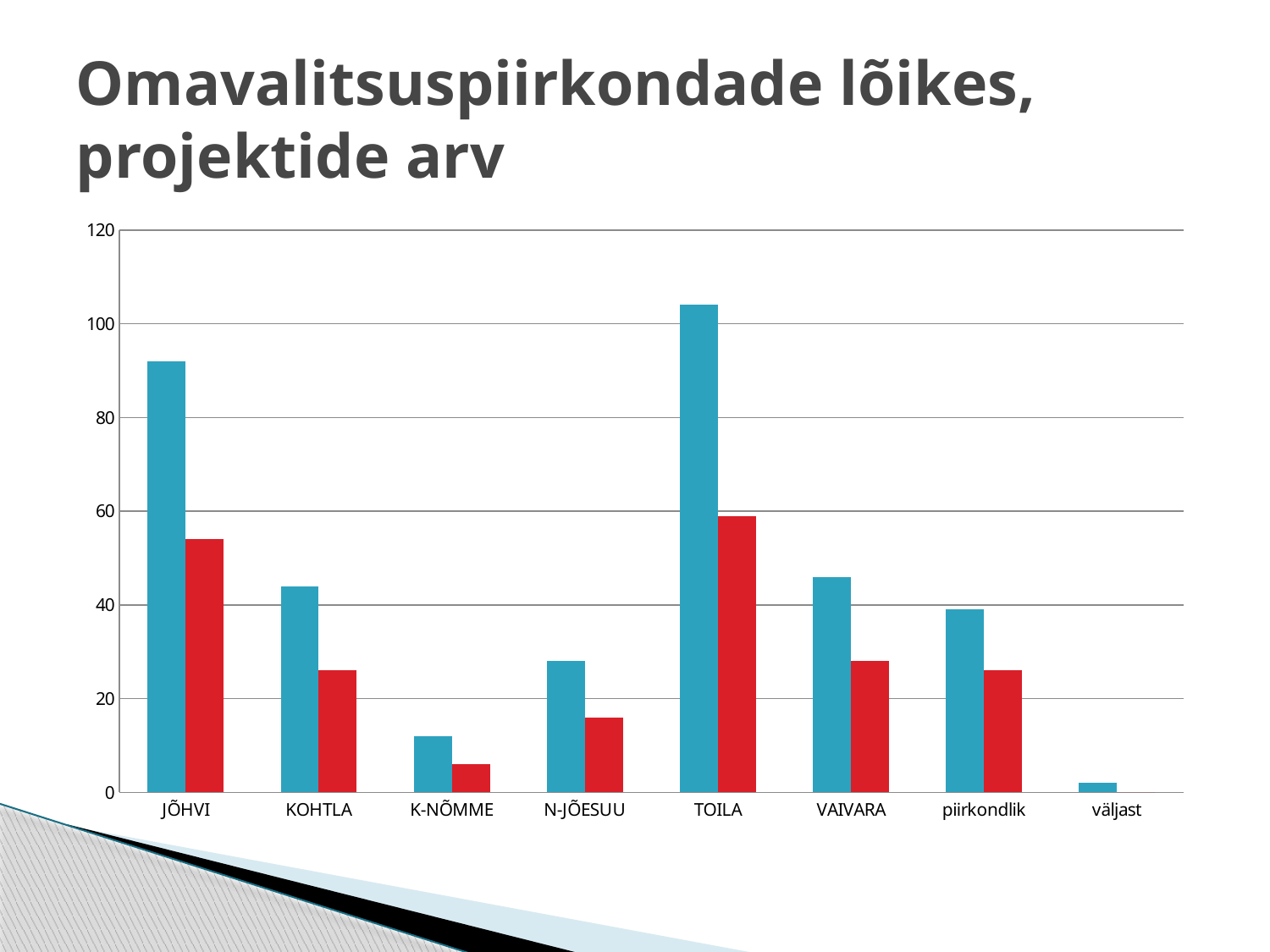
What kind of chart is shown on the slide? bar chart How many categories are shown on the x axis of the chart? 8 What is the title of the slide containing the chart? Omavalitsuspiirkondade lõikes, projektide arv Is the red bar for JÕHVI greater or less than 40? greater Is the red bar for N-JÕESUU greater or less than 20? less Which is larger, the blue bar for JÕHVI or the blue bar for KOHTLA? JÕHVI Is the blue bar for TOILA greater or less than 100? greater Which category has the shortest blue bar? väljast Which is larger, the red bar for TOILA or the red bar for VAIVARA? TOILA Which category has the tallest blue bar? TOILA